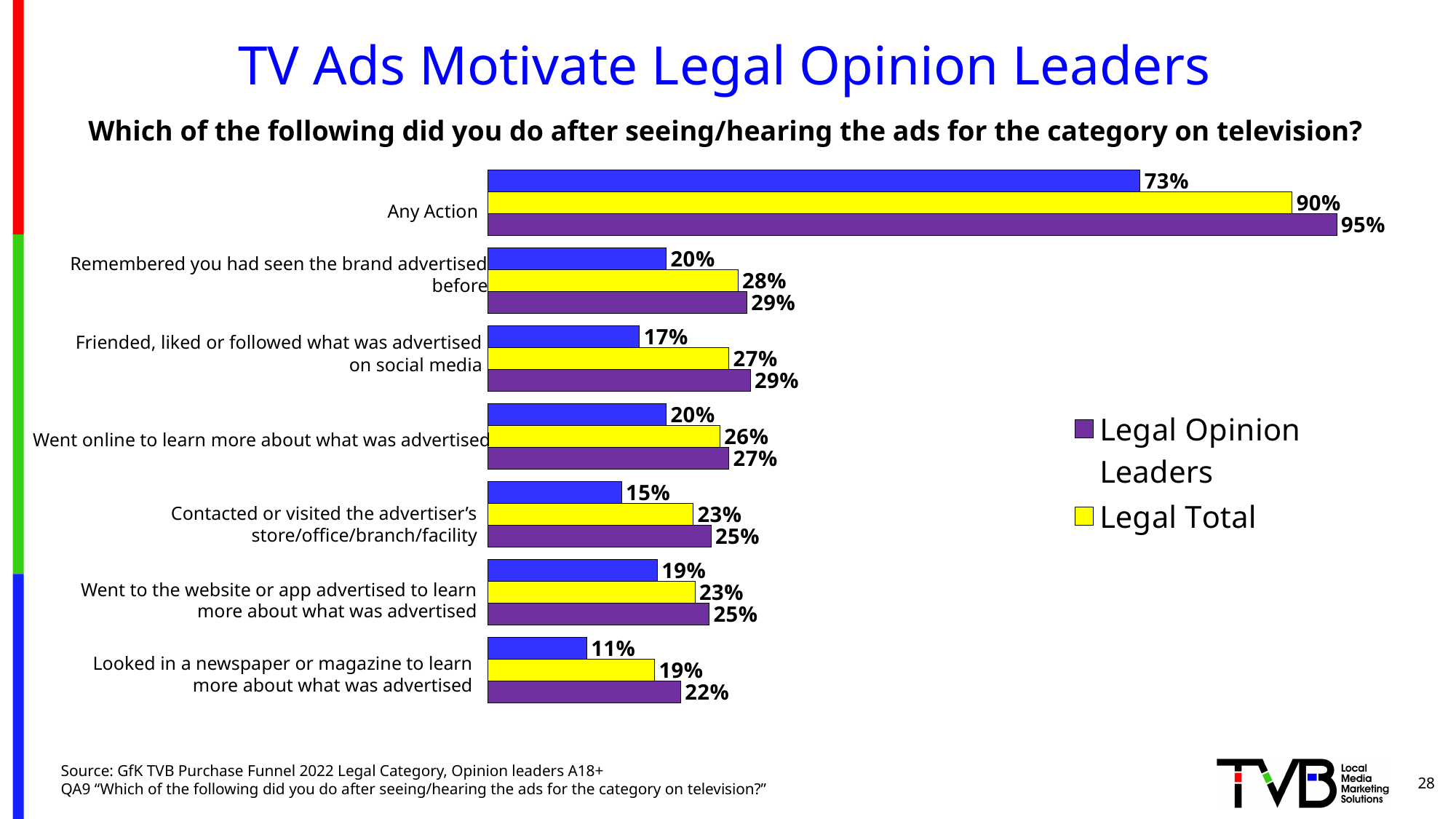
What is the difference between the Legal Opinion Leaders and Legal Total values for Any Action? 5% Which is larger for 'Friended, liked or followed what was advertised on social media': the Legal Opinion Leaders value or the Legal Total value? Legal Opinion Leaders What is the Legal Total value for 'Went online to learn more about what was advertised'? 26% What colour represents Legal Total in the legend? yellow What is the Legal Total value for Any Action? 90% Which category has the highest Legal Opinion Leaders value? Any Action What is the Legal Opinion Leaders value for Any Action? 95% What is the Legal Opinion Leaders value for 'Looked in a newspaper or magazine to learn more about what was advertised'? 22% What kind of chart is shown on the slide? bar chart How many series does the legend list? 2 Which category has the lowest Legal Total value? Looked in a newspaper or magazine to learn more about what was advertised How many categories are shown on the chart? 7